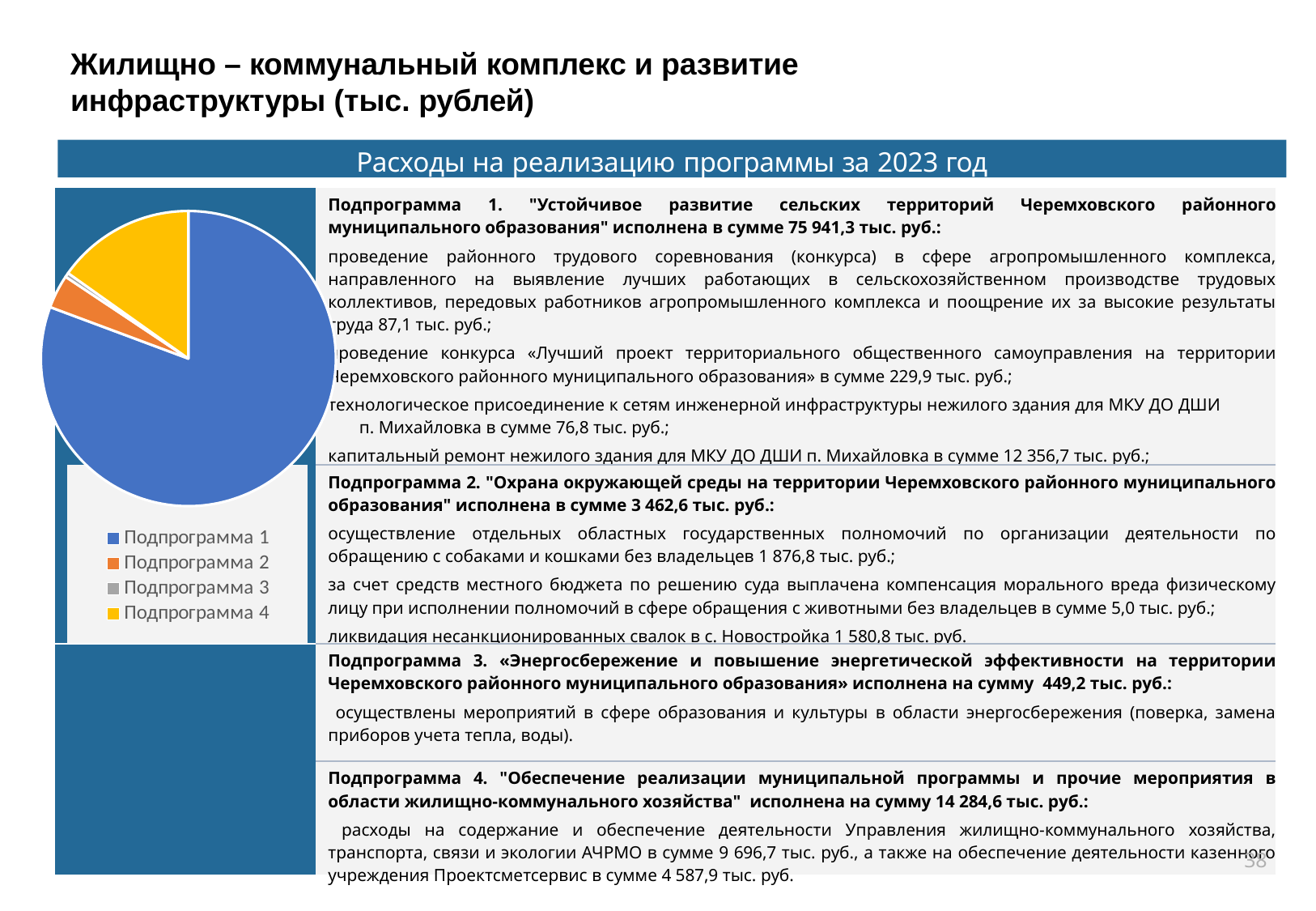
What colour is the slice for Подпрограмма 1 in the pie chart? blue What colour is the slice for Подпрограмма 4 in the pie chart? yellow Which subprogram has the smallest slice in the pie chart? Подпрограмма 3 Which slice is larger in the pie chart, Подпрограмма 4 or Подпрограмма 2? Подпрограмма 4 Which slice is larger in the pie chart, Подпрограмма 2 or Подпрограмма 3? Подпрограмма 2 Which subprogram has the largest slice in the pie chart? Подпрограмма 1 How many slices does the pie chart have? 4 What kind of chart is shown on the slide? pie chart Which slice is larger in the pie chart, Подпрограмма 1 or Подпрограмма 4? Подпрограмма 1 How many entries does the legend of the pie chart list? 4